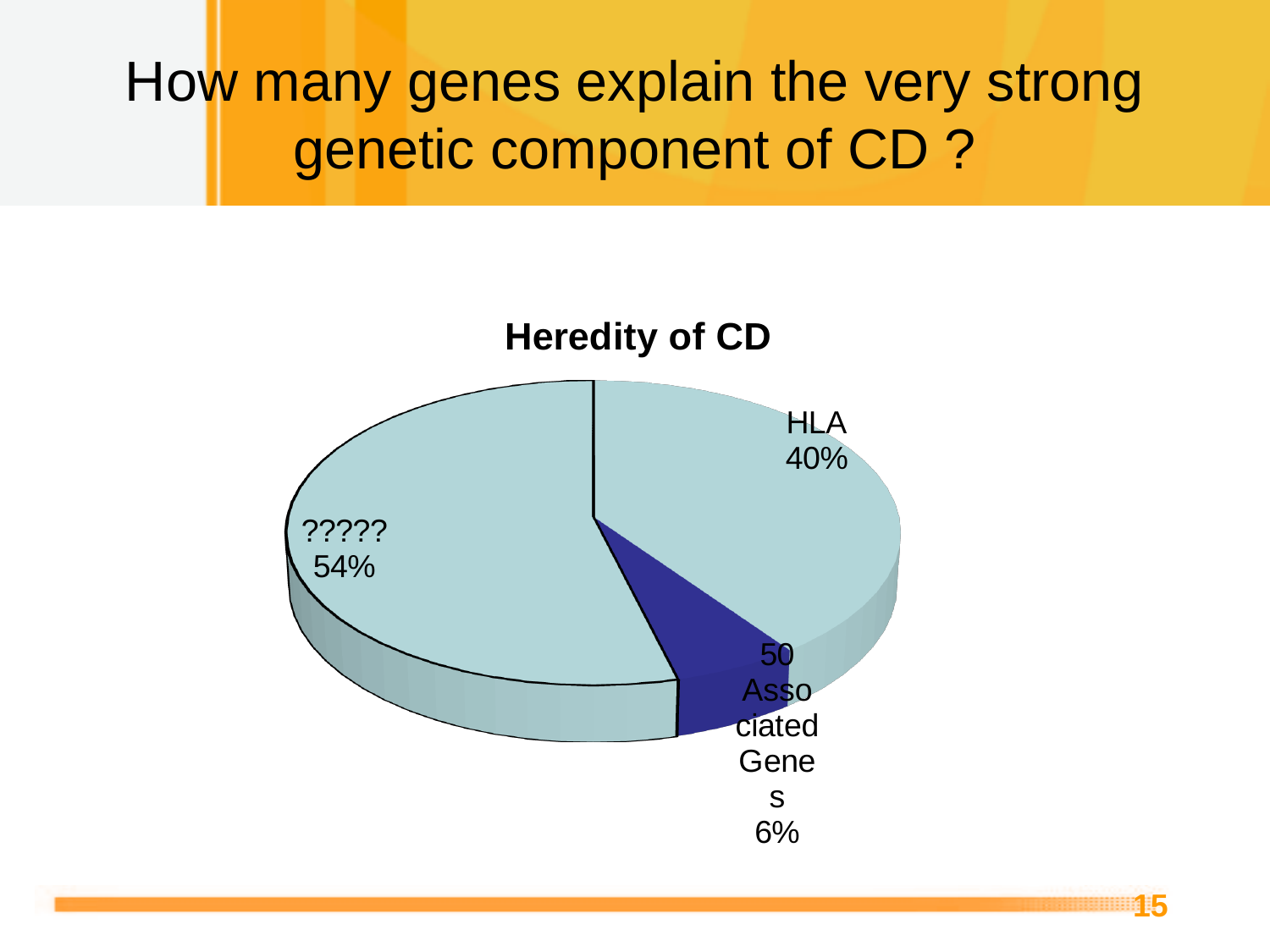
What colour is the 50 Associated Genes slice? dark blue Which slice of the pie is the smallest? 50 Associated Genes Which is larger, the HLA slice or the 50 Associated Genes slice? HLA Which slice of the pie is the largest? ????? How many slices does the pie chart have? 3 What is the difference in percentage points between the ????? slice and the HLA slice? 14 What is the title of the chart? Heredity of CD What is the difference in percentage points between the HLA slice and the 50 Associated Genes slice? 34 What share of the pie does HLA account for? 40% What kind of chart is shown on the slide? pie chart What share of the pie does the ????? slice account for? 54% What share of the pie do the 50 Associated Genes account for? 6%